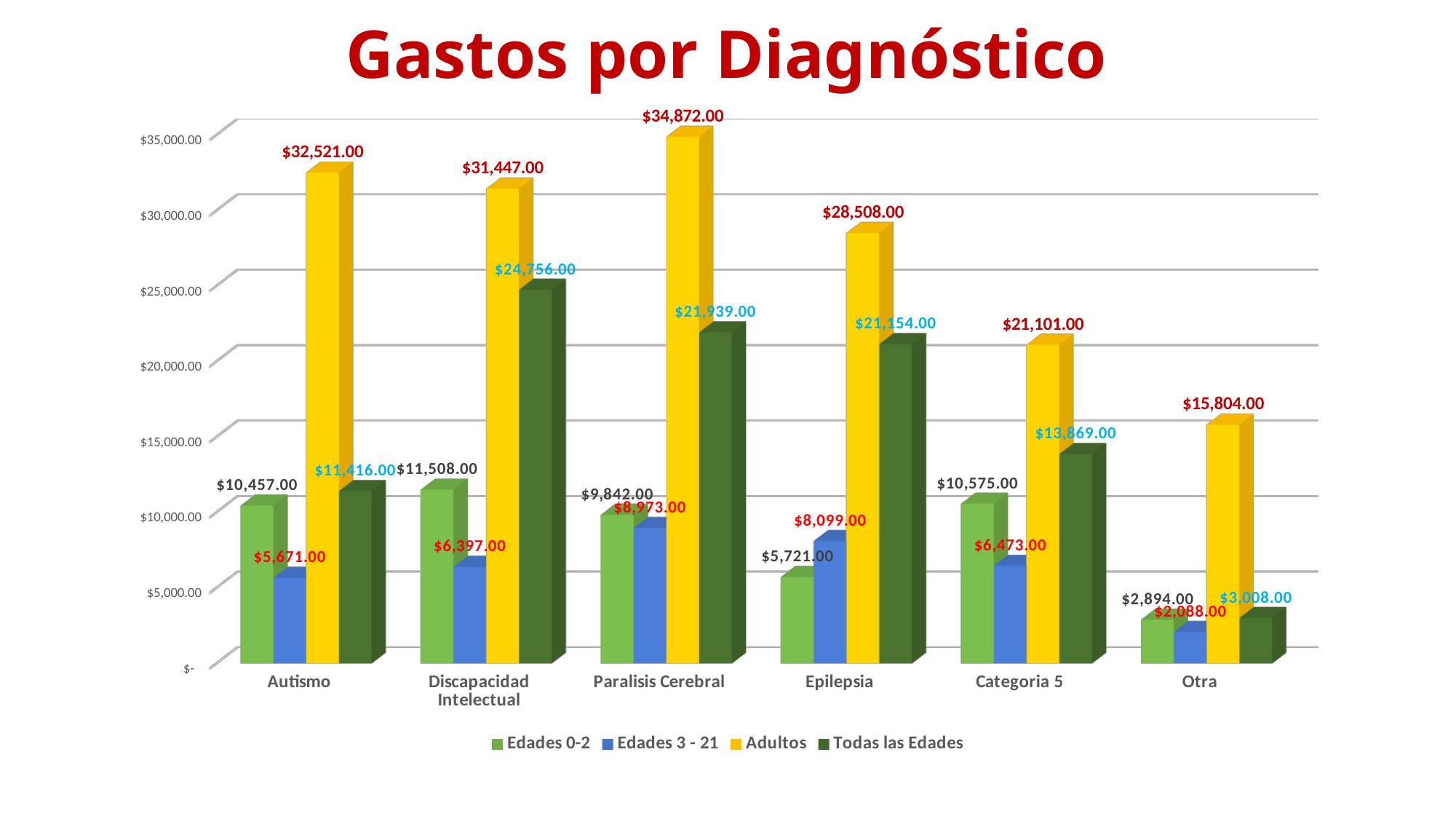
Which category has the lowest value for the Edades 3 - 21 series? Otra What kind of chart is shown on the slide? Bar chart What is the value for Edades 0-2 in the Otra category? $2,894.00 What is the title of the chart? Gastos por Diagnóstico What is the difference between the Adultos values for Paralisis Cerebral and Autismo? $2,351.00 Which is larger: the Edades 0-2 value for Autismo or the Edades 0-2 value for Categoria 5? Categoria 5 How many series does the legend list? 4 What is the value for Edades 3 - 21 in the Epilepsia category? $8,099.00 How many categories are shown on the x axis? 6 What is the value for Todas las Edades in the Discapacidad Intelectual category? $24,756.00 Which category has the highest value for the Adultos series? Paralisis Cerebral What is the value for Adultos in the Paralisis Cerebral category? $34,872.00